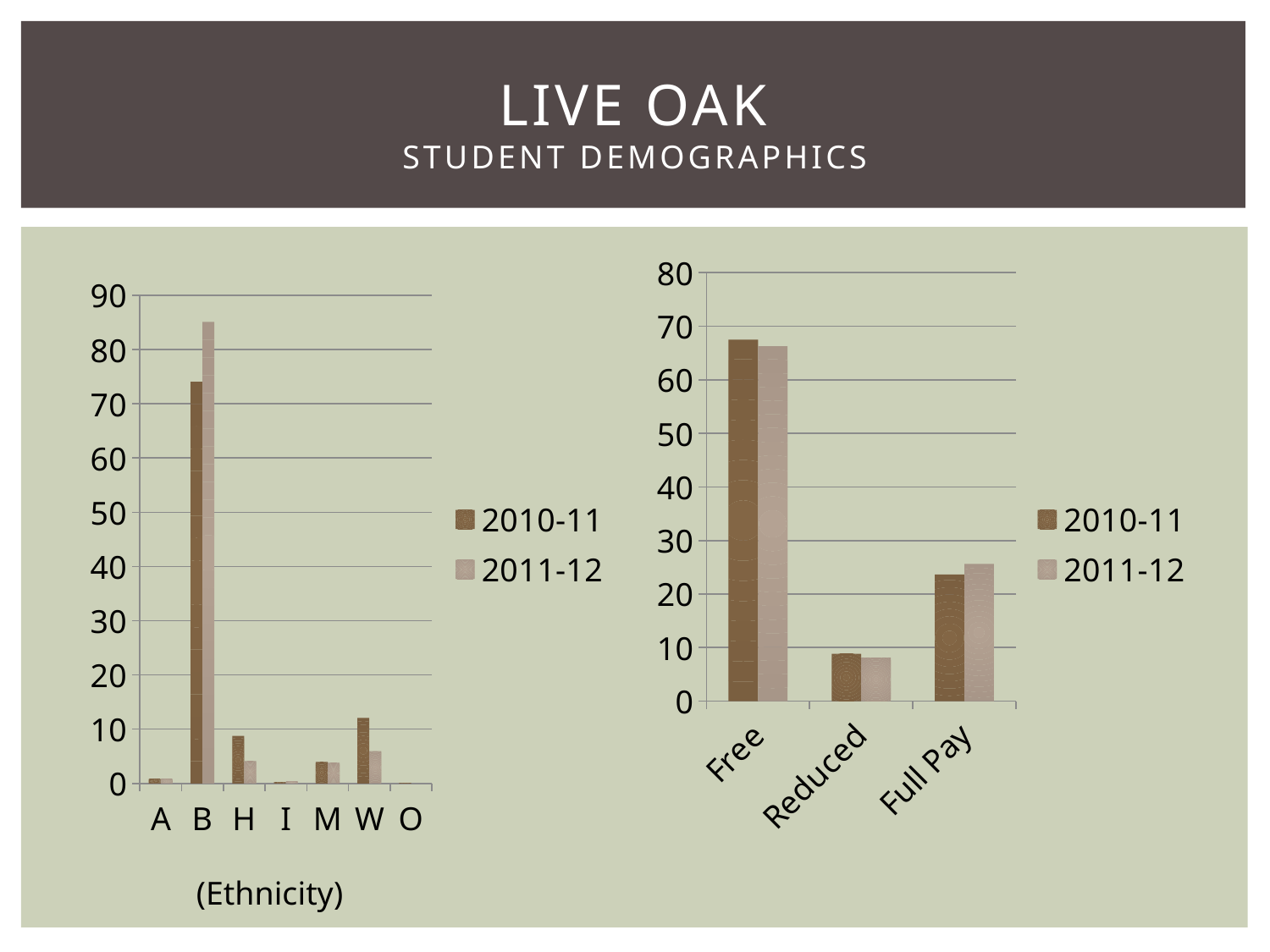
In the chart on the right, is the 2011-12 value for Full Pay greater or less than 20? greater What kind of chart is the Ethnicity chart on the left of the slide? bar chart In the Ethnicity chart on the left, which series has the larger value for W, 2010-11 or 2011-12? 2010-11 In the chart on the right (Free, Reduced, Full Pay), how many categories are shown on the x axis? 3 In the Ethnicity chart on the left, is the 2011-12 value for B greater or less than 80? greater In the chart on the right (Free, Reduced, Full Pay), which category has the lowest value for 2011-12? Reduced In the Ethnicity chart on the left, is the 2010-11 value for B greater or less than 70? greater In the chart on the right (Free, Reduced, Full Pay), which category has the highest value for 2010-11? Free In the Ethnicity chart on the left, how many series does the legend list? 2 In the Ethnicity chart on the left, which category has the highest value for 2011-12? B In the Ethnicity chart on the left, how many categories are shown on the x axis? 7